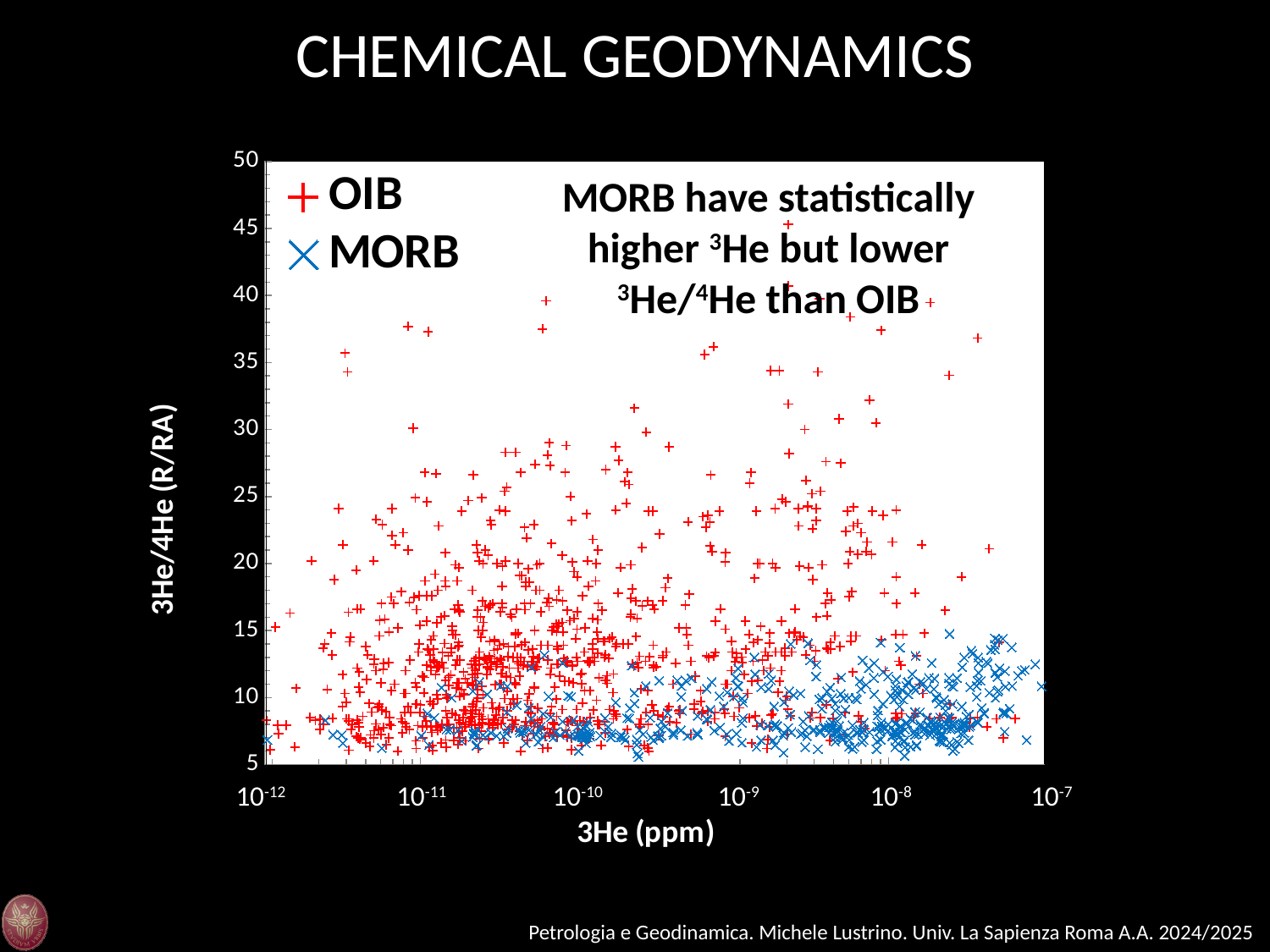
What is the lowest x-axis tick value shown? 10^-12 Is the highest 3He/4He value plotted for MORB greater or less than 20? less How many series does the legend list? 2 What is the maximum value shown on the y axis? 50 What kind of chart is shown on the slide? scatter plot What is the minimum value shown on the y axis? 5 Which series reaches higher 3He/4He (R/RA) values, OIB or MORB? OIB Which series extends to higher 3He (ppm) concentrations, OIB or MORB? MORB Is the highest 3He/4He value plotted for OIB greater or less than 40? greater